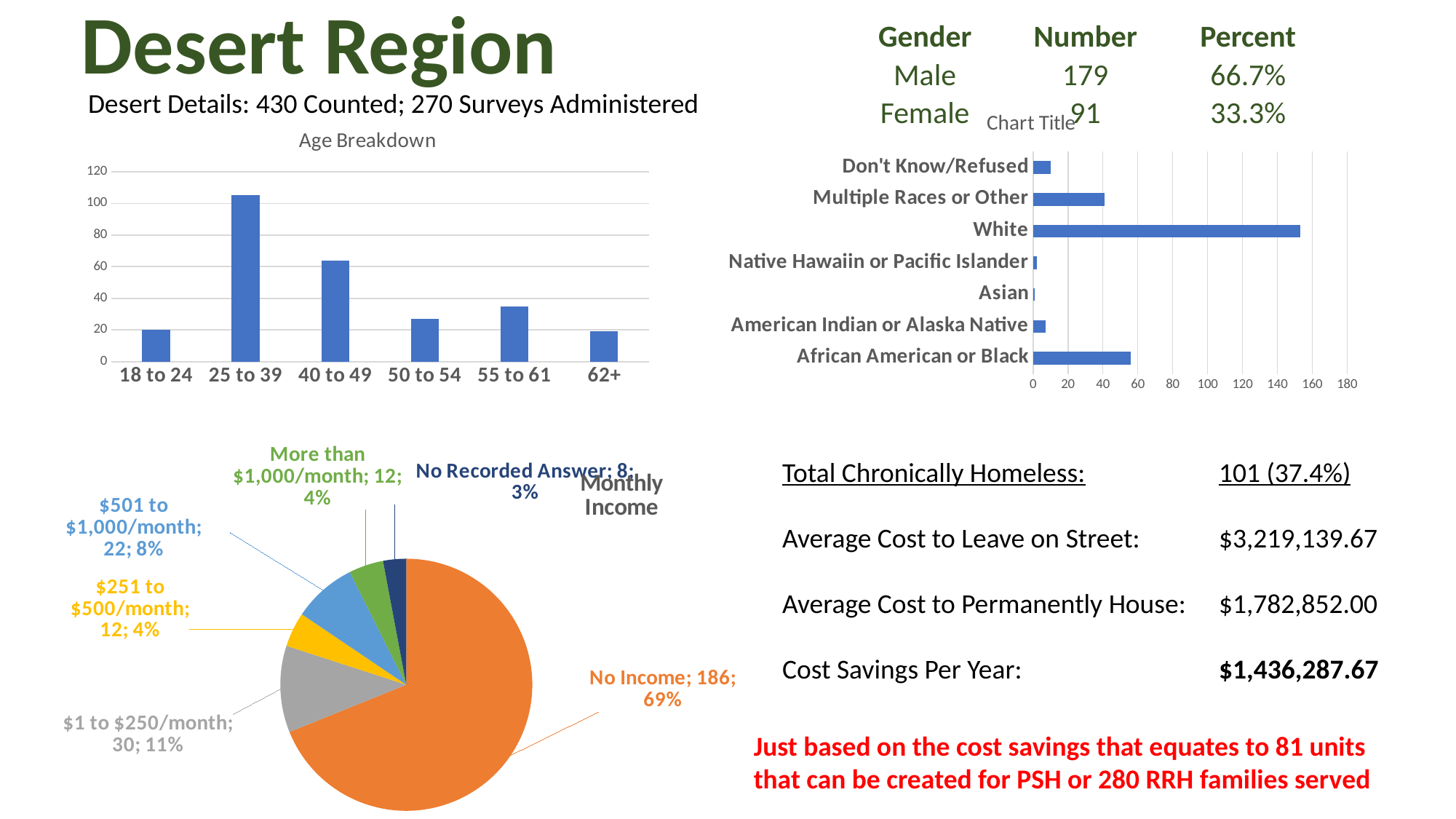
In the Monthly Income pie chart, how many people reported No Income? 186 In the Age Breakdown chart, is the value for 25 to 39 greater or less than 100? greater In the Age Breakdown chart, which is larger, the value for 55 to 61 or the value for 50 to 54? 55 to 61 In the Monthly Income pie chart, what share of the pie is No Income? 69% What type of chart is the Monthly Income chart? pie chart In the Age Breakdown chart, is the value for 40 to 49 greater or less than 60? greater In the race bar chart on the right (titled Chart Title), is the value for White greater or less than 140? greater In the Age Breakdown chart, which age group has the highest value? 25 to 39 In the race bar chart on the right (titled Chart Title), how many categories are shown? 7 In the Age Breakdown chart, how many age groups are shown? 6 In the Monthly Income pie chart, what is the difference between the No Income count and the $1 to $250/month count? 156 In the race bar chart on the right (titled Chart Title), which category has the highest value? White